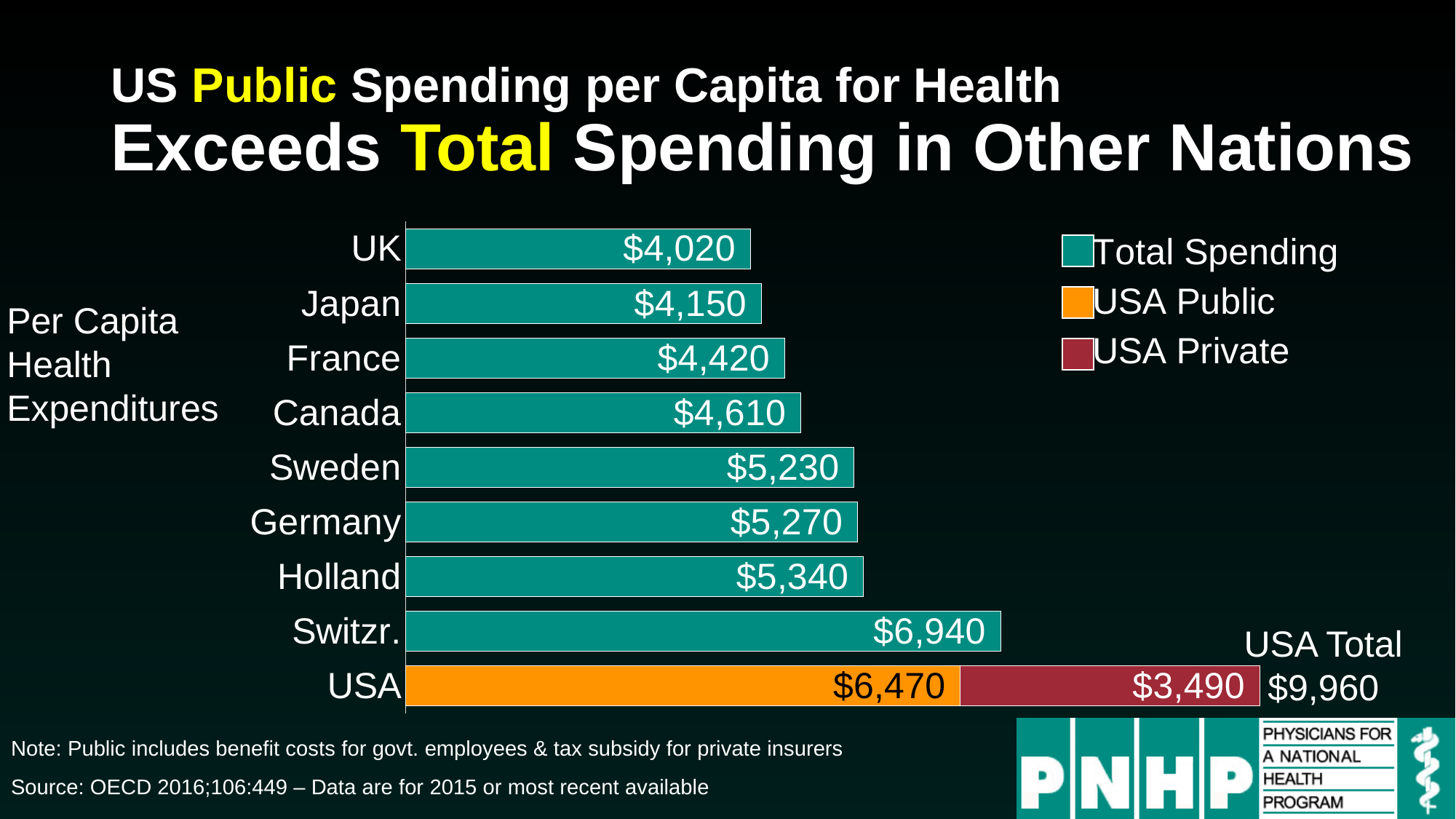
What is the USA total per capita health spending shown on the chart? $9,960 Which country has the lowest per capita health spending on the chart? UK What colour is used for the USA Public bar? Orange What is the difference between Switzerland's total spending and the UK's total spending? $2,920 What is the per capita health spending value shown for Canada? $4,610 Which is larger, the USA Public spending or Switzerland's total spending? Switzerland's total spending What is the USA Public spending value shown on the chart? $6,470 What is the USA Private spending value shown on the chart? $3,490 What type of chart is shown on the slide? Bar chart How many entries does the legend list? 3 Among the countries other than the USA, which has the highest total spending? Switzr. How many countries are listed on the chart? 9